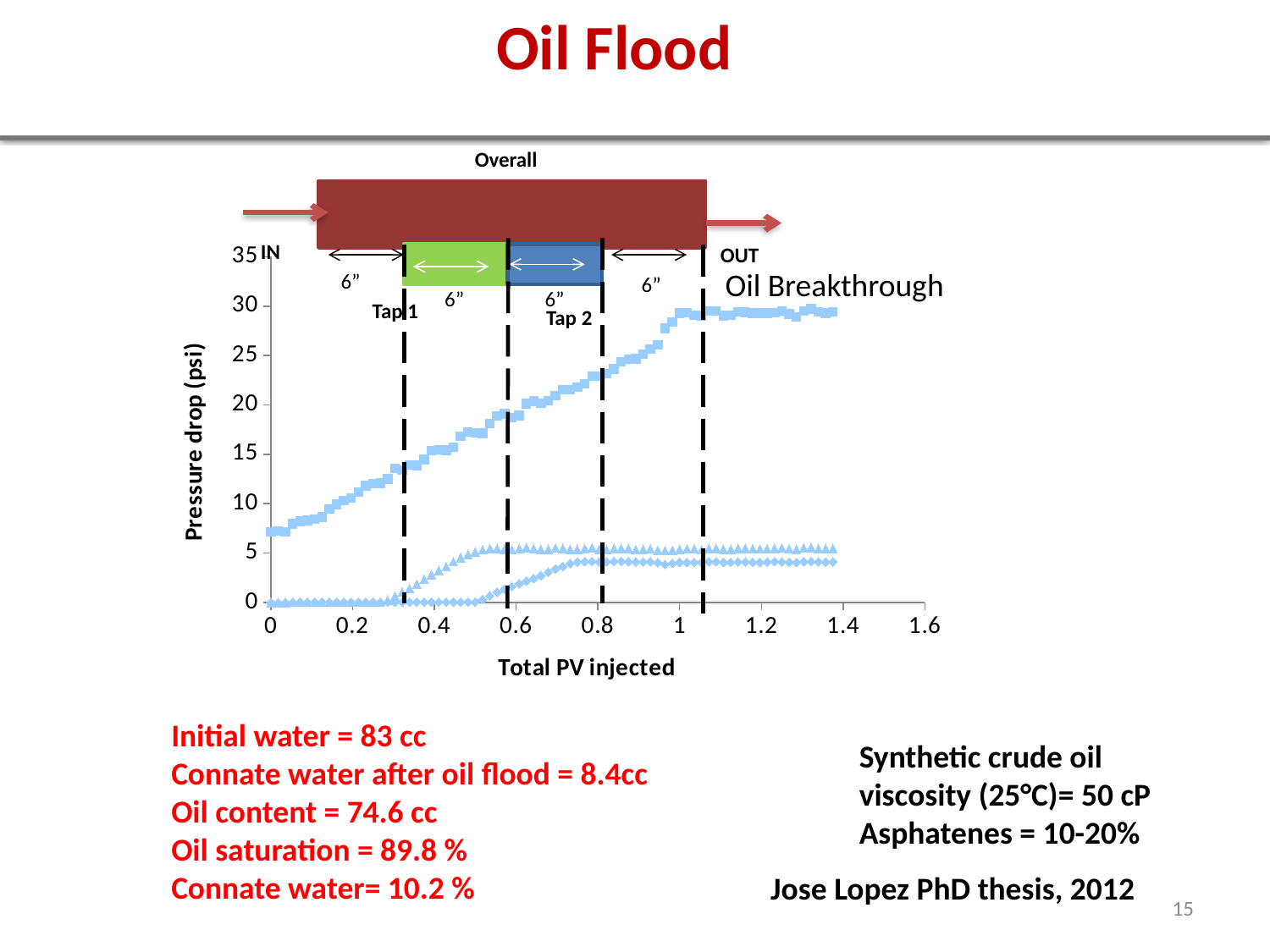
What kind of chart is shown on the slide? scatter chart Which series has the lowest pressure drop at Total PV injected = 1.2: square, triangle, or diamond markers? diamond markers Is the value of the triangle-marker series at Total PV injected = 1.2 greater or less than 10? less Is the value of the square-marker series at Total PV injected = 0.2 greater or less than 15? less What is the label of the y-axis of the chart? Pressure drop (psi) Which series reaches the highest pressure drop on the chart: the one with square markers, triangle markers, or diamond markers? square markers How many data series (distinct marker shapes) are plotted on the chart? 3 What is the highest tick value shown on the x-axis of the chart? 1.6 What is the label of the x-axis of the chart? Total PV injected Does the series plotted with square markers rise or fall as Total PV injected increases from 0 to 1? rise At Total PV injected = 1.2, which series has the larger pressure drop: the square-marker series or the diamond-marker series? square-marker series Is the value of the square-marker series at Total PV injected = 1.2 greater or less than 25? greater